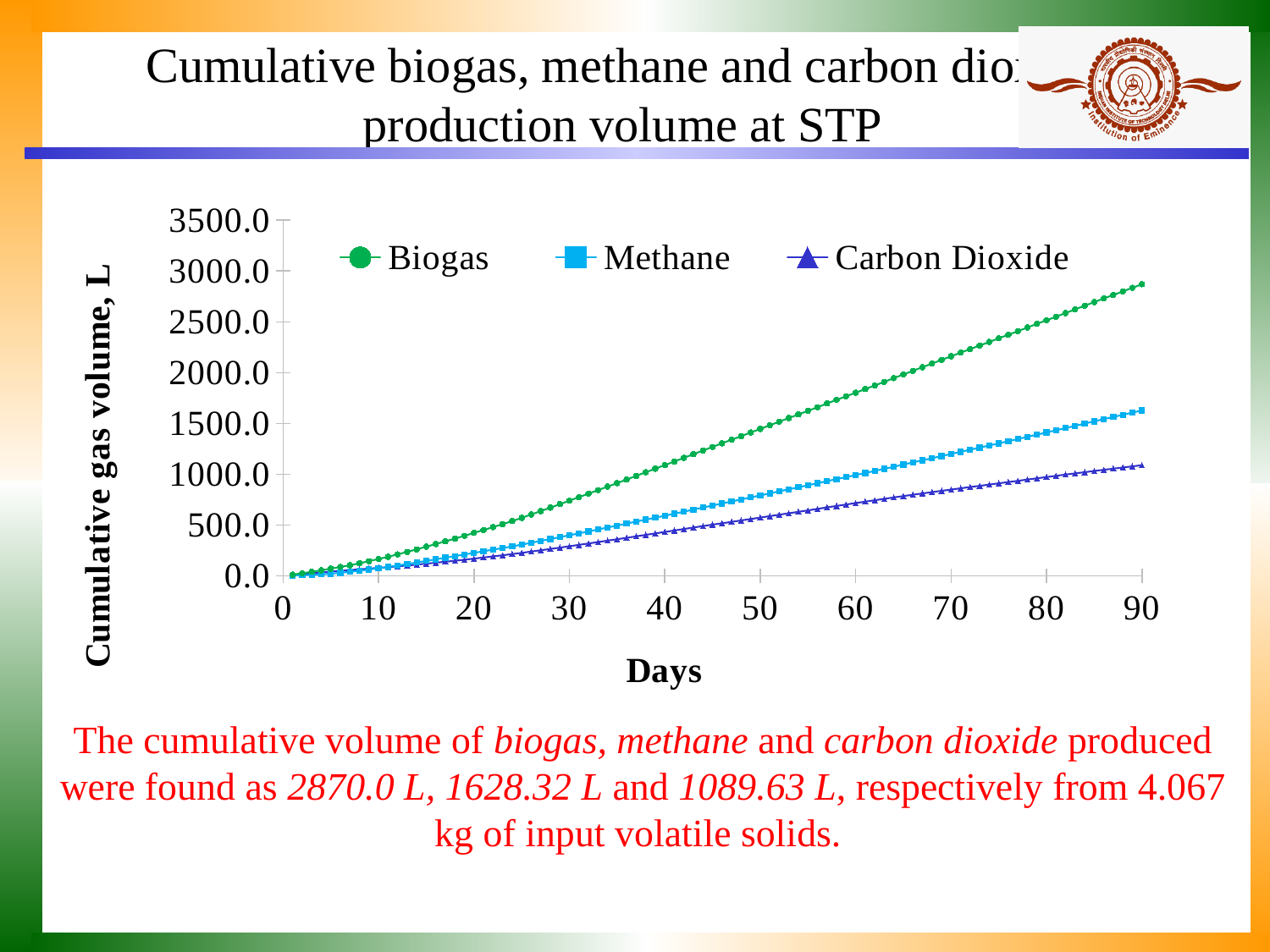
How many series does the legend list? 3 What is the difference between the final cumulative biogas volume and the final cumulative methane volume? 1241.68 L Which series reaches the highest cumulative gas volume at day 90? Biogas Which series has the lowest cumulative gas volume at day 90? Carbon Dioxide What is the cumulative volume of methane produced at the end of the 90 days? 1628.32 L What is the cumulative volume of carbon dioxide produced at the end of the 90 days? 1089.63 L Is the cumulative biogas volume at day 90 greater or less than 2500.0 L? greater Is the cumulative methane volume at day 50 greater or less than 1000.0 L? less What is the cumulative volume of biogas produced at the end of the 90 days? 2870.0 L Do the cumulative gas volumes rise or fall as the number of days increases? rise What is the label of the x axis? Days What type of chart is shown on the slide? line chart